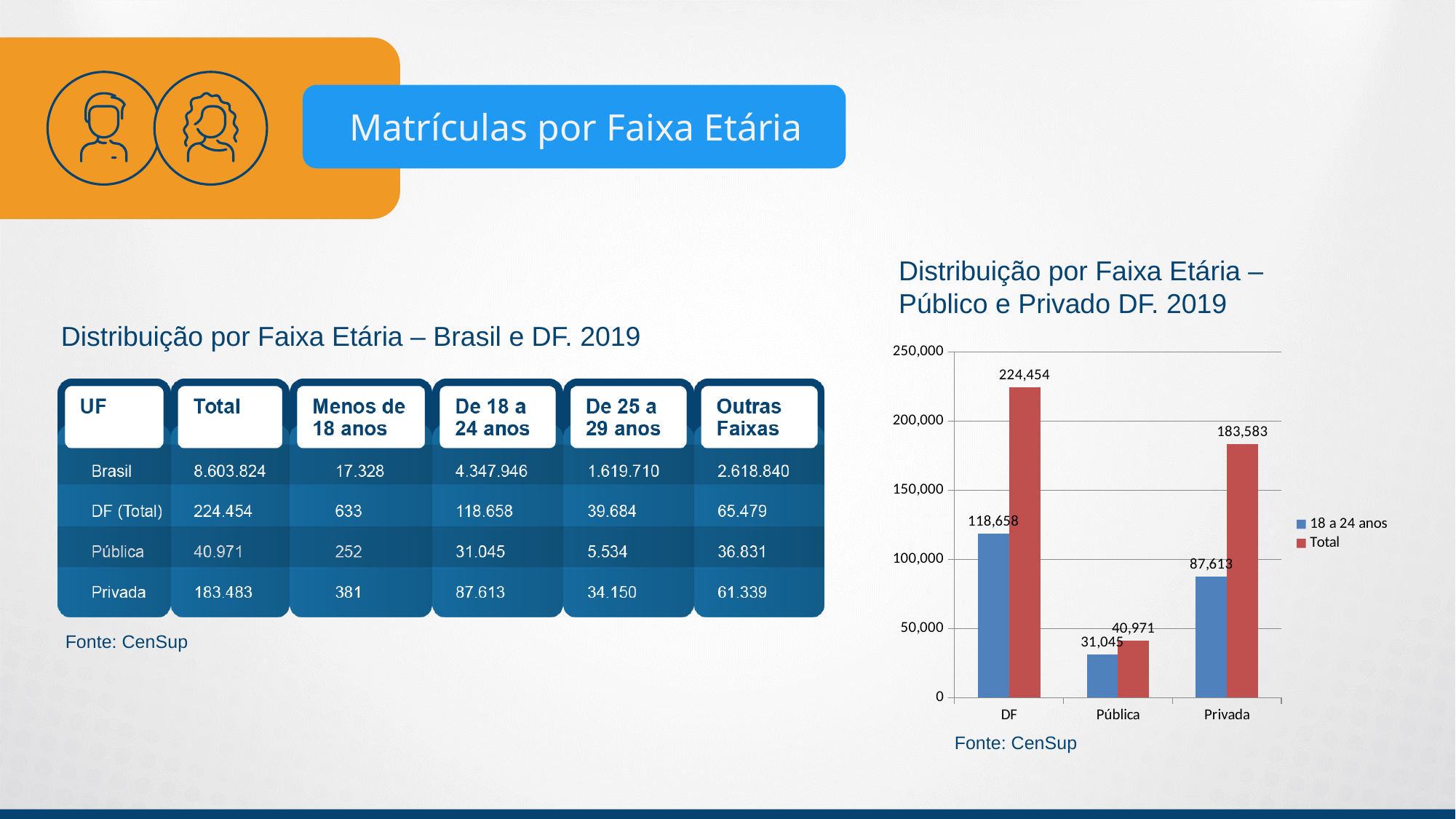
What type of chart is shown on the slide? bar chart What is the difference between the Total and the 18 a 24 anos values for DF in the chart? 105,796 What is the value of the Total series for Privada in the chart? 183,583 Which category has the highest Total value in the chart? DF How many series does the chart legend list? 2 What is the difference between the Total values for Privada and Pública in the chart? 142,612 Which category has the lowest 18 a 24 anos value in the chart? Pública What is the value of the 18 a 24 anos series for Privada in the chart? 87,613 In the chart, is the 18 a 24 anos value for Privada larger or smaller than the Total value for Pública? larger What is the value of the 18 a 24 anos series for Pública in the chart? 31,045 What is the value of the Total series for DF in the chart? 224,454 How many categories are shown on the x axis of the chart? 3